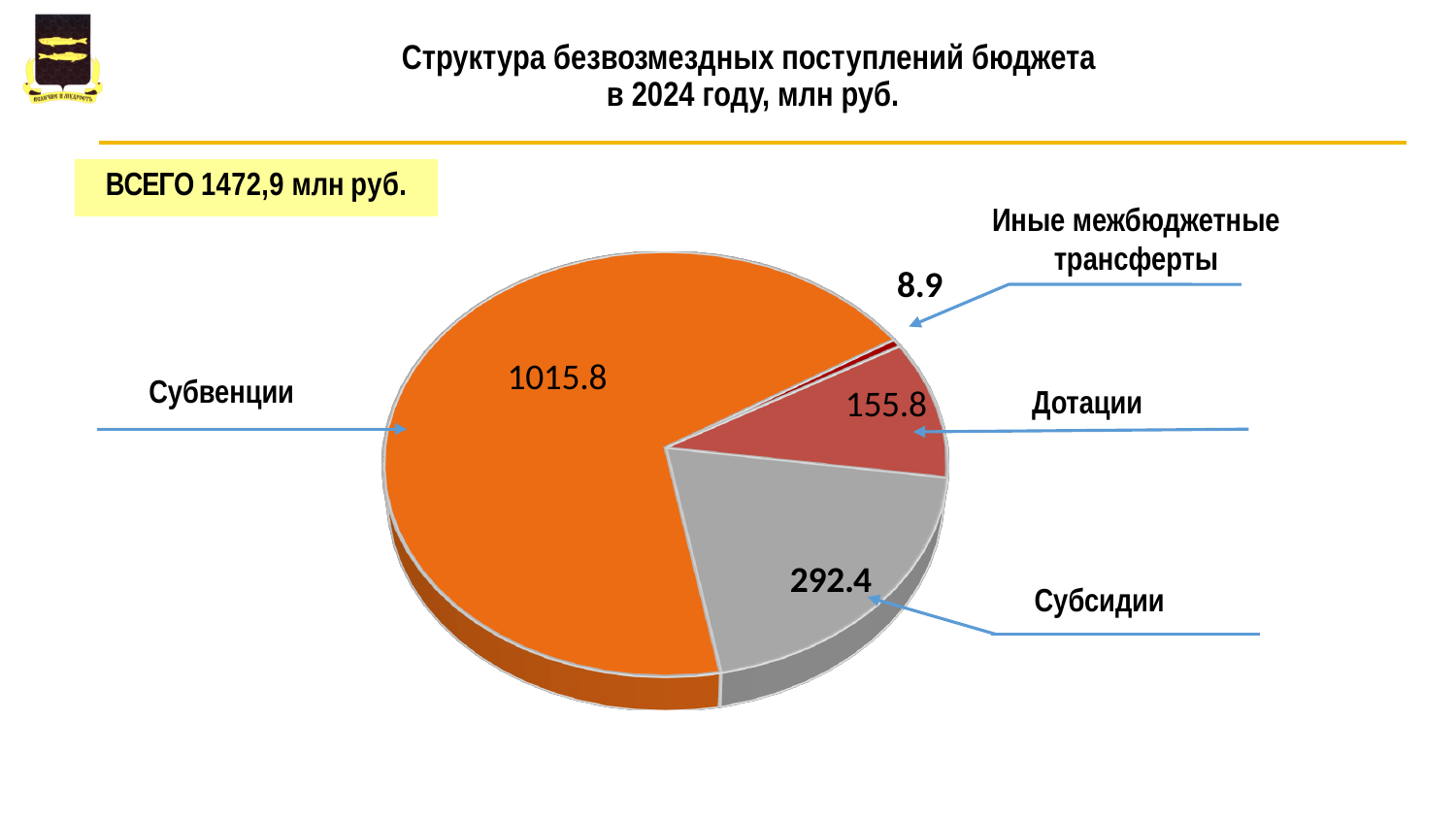
What is the value for Дотации? 155.8 Which is larger, the value for Дотации or the value for Субсидии? Субсидии What is the value for Иные межбюджетные трансферты? 8.9 Which category has the smallest slice of the pie? Иные межбюджетные трансферты What kind of chart is shown on the slide? Pie chart What is the difference between the values for Субвенции and Субсидии? 723.4 What is the value for Субвенции? 1015.8 What total amount is stated on the slide for all gratuitous receipts (ВСЕГО)? 1472,9 млн руб. What is the difference between the values for Субсидии and Дотации? 136.6 How many slices does the pie chart have? 4 What is the value for Субсидии? 292.4 Which category has the largest slice of the pie? Субвенции